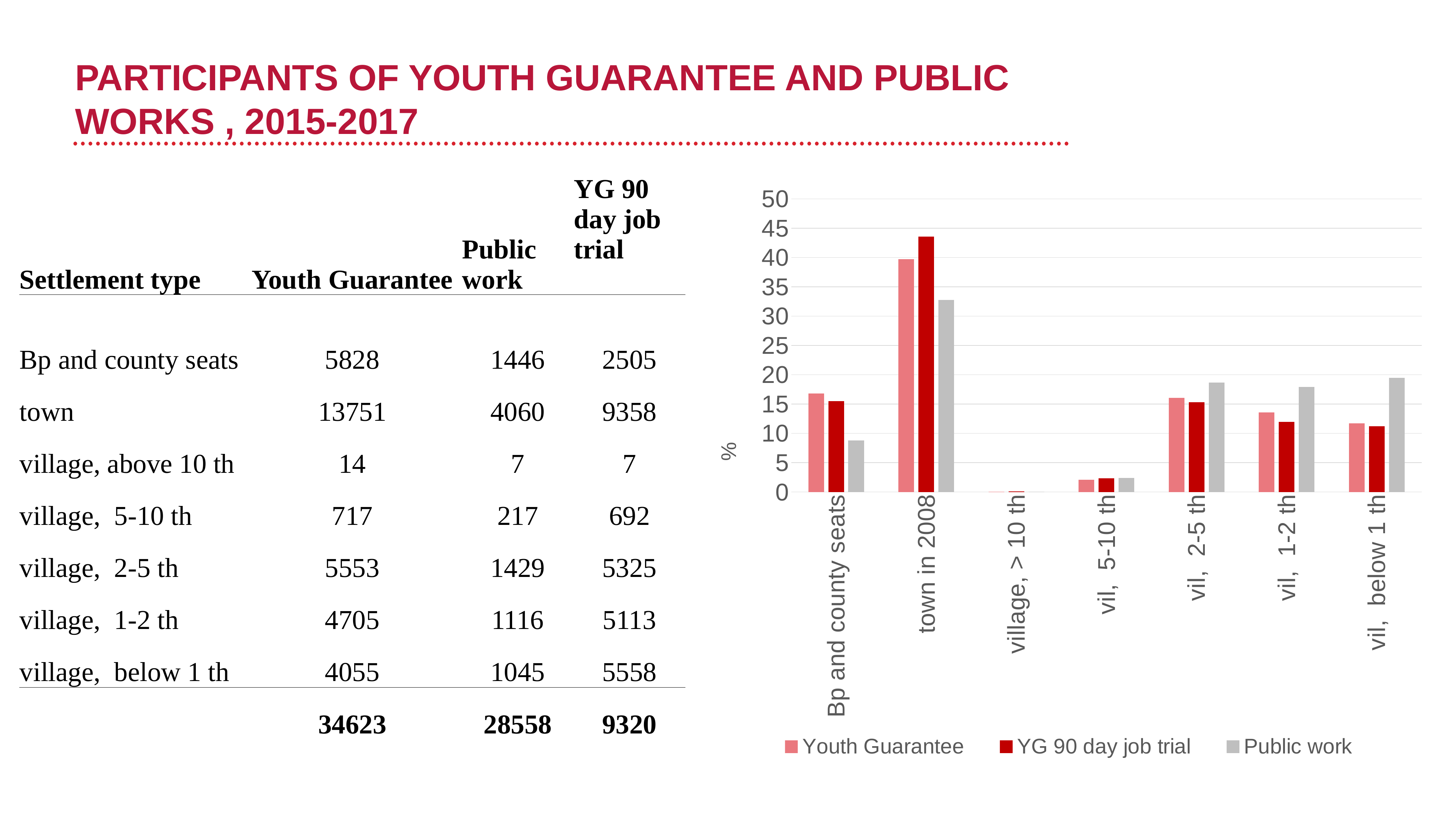
Is the Public work value for town in 2008 greater or less than 30? greater Is the YG 90 day job trial value for town in 2008 greater or less than 40? greater What kind of chart is shown on the slide? bar chart For Bp and county seats, which is larger: the Youth Guarantee value or the Public work value? Youth Guarantee Which category has the highest Youth Guarantee value in the chart? town in 2008 What label is shown on the chart's vertical axis? % Which category has the lowest values across all three series in the chart? village, > 10 th For vil, below 1 th, which is larger: the Public work value or the Youth Guarantee value? Public work Is the Public work value for Bp and county seats greater or less than 10? less How many settlement categories are shown on the x axis of the chart? 7 How many series does the chart's legend list? 3